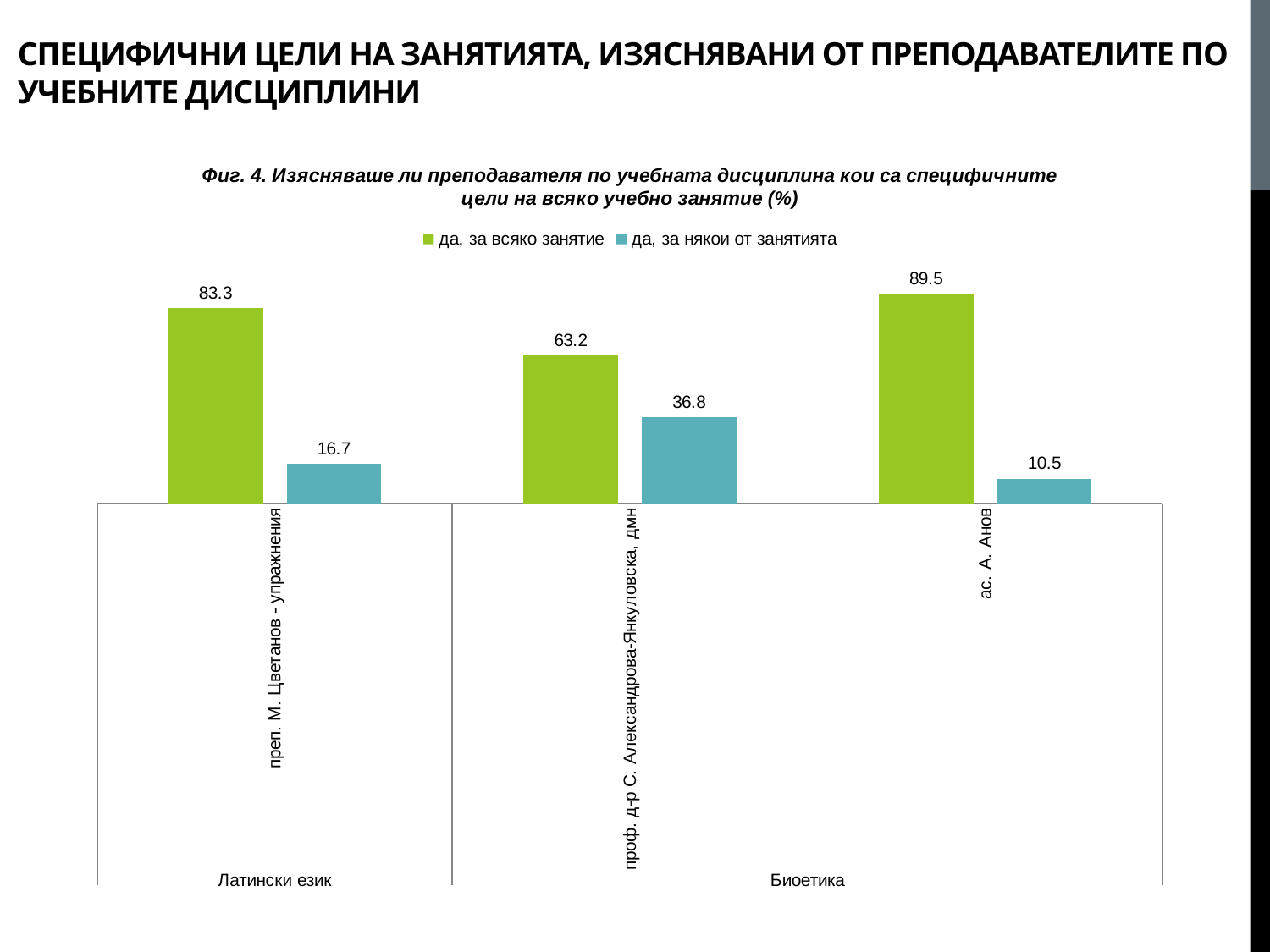
What is the total of the two series values for ас. А. Анов? 100 How many teachers (categories) are shown on the x axis? 3 What type of chart is shown on the slide? bar chart Which teacher has the highest value for "да, за всяко занятие"? ас. А. Анов What is the value of "да, за всяко занятие" for ас. А. Анов? 89.5 How many series does the legend list? 2 What is the difference between the "да, за всяко занятие" and "да, за някои от занятията" values for преп. М. Цветанов - упражнения? 66.6 What is the value of "да, за всяко занятие" for преп. М. Цветанов - упражнения? 83.3 What is the value of "да, за някои от занятията" for проф. д-р С. Александрова-Янкуловска, дмн? 36.8 Which discipline group contains two teachers on the x axis? Биоетика Which teacher has the lowest value for "да, за някои от занятията"? ас. А. Анов Which is larger: the "да, за някои от занятията" value for проф. д-р С. Александрова-Янкуловска, дмн or for преп. М. Цветанов - упражнения? проф. д-р С. Александрова-Янкуловска, дмн